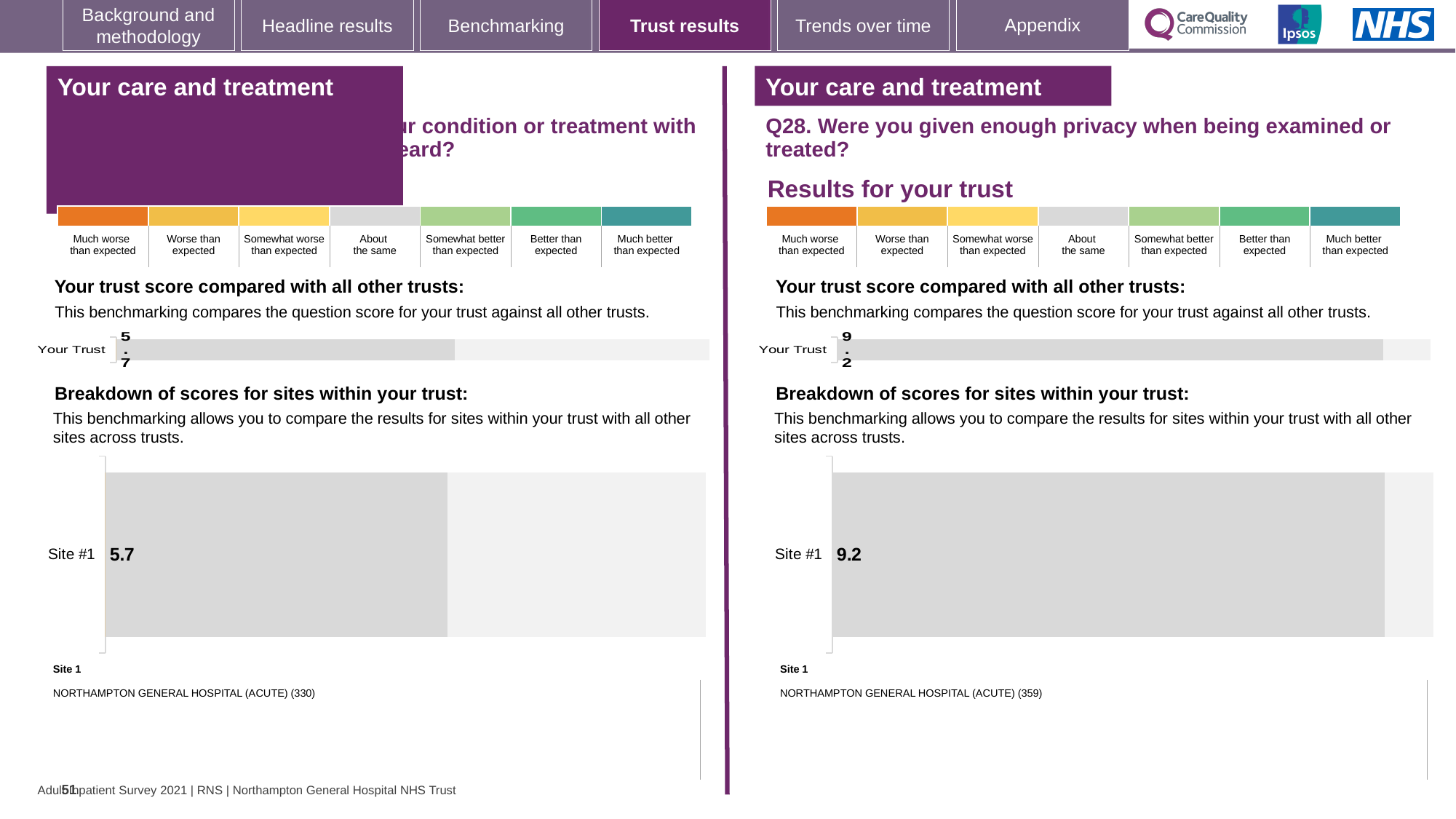
What kind of chart is used to show the Site #1 score on the right half of the slide (Q28)? Bar chart How many sites are shown in the 'Breakdown of scores for sites within your trust' chart on the left half of the slide? 1 Which site name is listed as Site 1 beneath the breakdown chart on the left half of the slide? NORTHAMPTON GENERAL HOSPITAL (ACUTE) (330) Which site name is listed as Site 1 beneath the breakdown chart on the right half of the slide (Q28)? NORTHAMPTON GENERAL HOSPITAL (ACUTE) (359) On the right half of the slide (Q28), what is the score shown for Your Trust in the 'Your trust score compared with all other trusts' chart? 9.2 On the left half of the slide, what is the score shown for Your Trust in the 'Your trust score compared with all other trusts' chart? 5.7 What kind of chart is used to show the Your Trust score on the left half of the slide? Bar chart Which is larger: the Site #1 score in the left-hand breakdown chart or the Site #1 score in the right-hand (Q28) breakdown chart? The right-hand (Q28) chart On the right half of the slide (Q28), what is the score shown for Site #1 in the 'Breakdown of scores for sites within your trust' chart? 9.2 What is the difference between the Site #1 score in the right-hand (Q28) breakdown chart and the Site #1 score in the left-hand breakdown chart? 3.5 On the left half of the slide, what is the score shown for Site #1 in the 'Breakdown of scores for sites within your trust' chart? 5.7 How many sites are shown in the 'Breakdown of scores for sites within your trust' chart on the right half of the slide (Q28)? 1